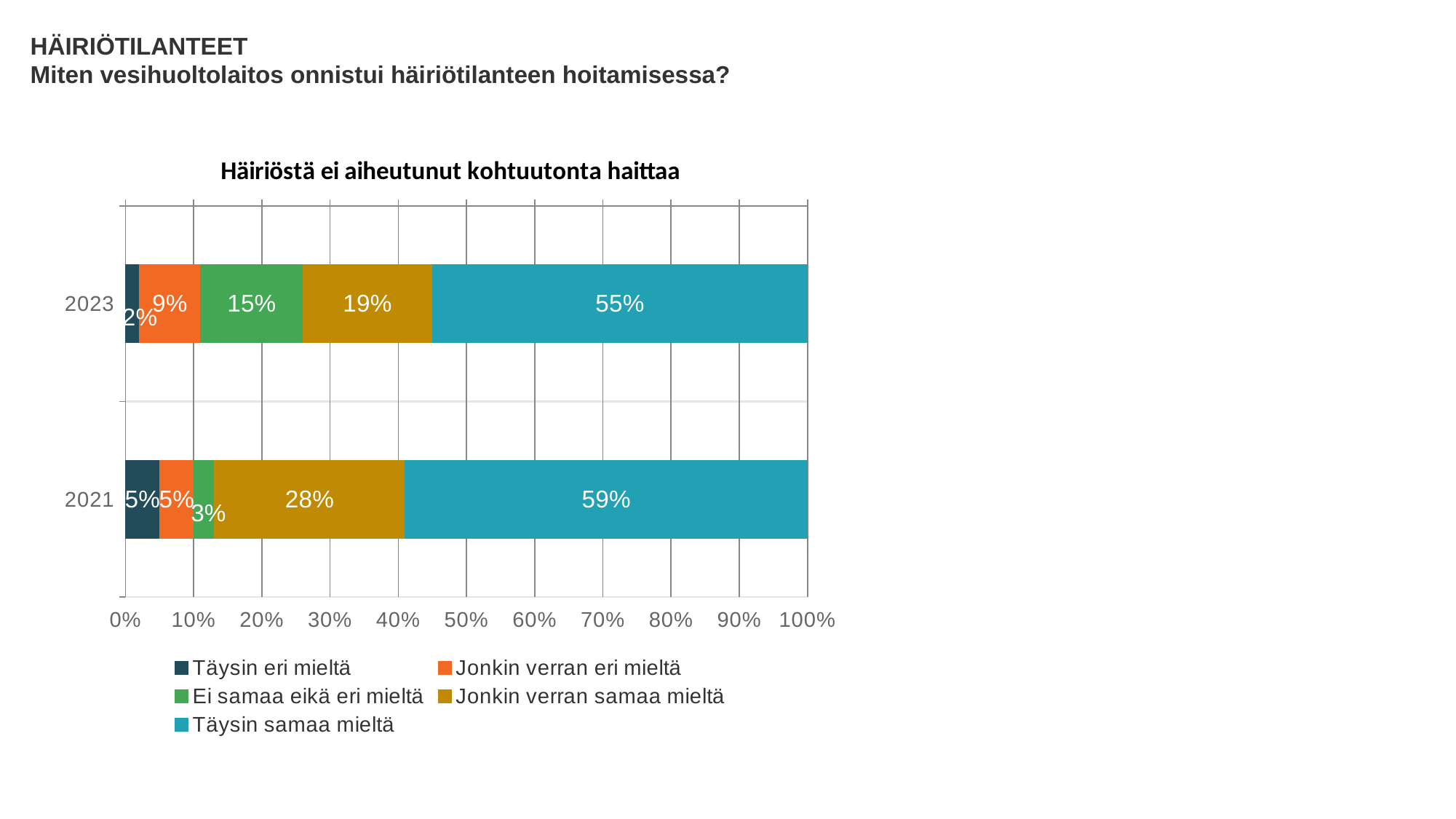
What type of chart is shown on the slide? Stacked bar chart Which series has the lowest value in 2023? Täysin eri mieltä What is the chart's title? Häiriöstä ei aiheutunut kohtuutonta haittaa What is the difference between the 'Täysin samaa mieltä' values for 2021 and 2023? 4% What is the value for 'Täysin samaa mieltä' in 2023? 55% What is the value for 'Täysin eri mieltä' in 2021? 5% What is the value for 'Ei samaa eikä eri mieltä' in 2023? 15% How many series does the legend list? 5 Which series has the highest value in 2021? Täysin samaa mieltä How many years (categories) are shown in the chart? 2 Which is larger: 'Jonkin verran eri mieltä' in 2023 or in 2021? 2023 What is the value for 'Jonkin verran samaa mieltä' in 2021? 28%